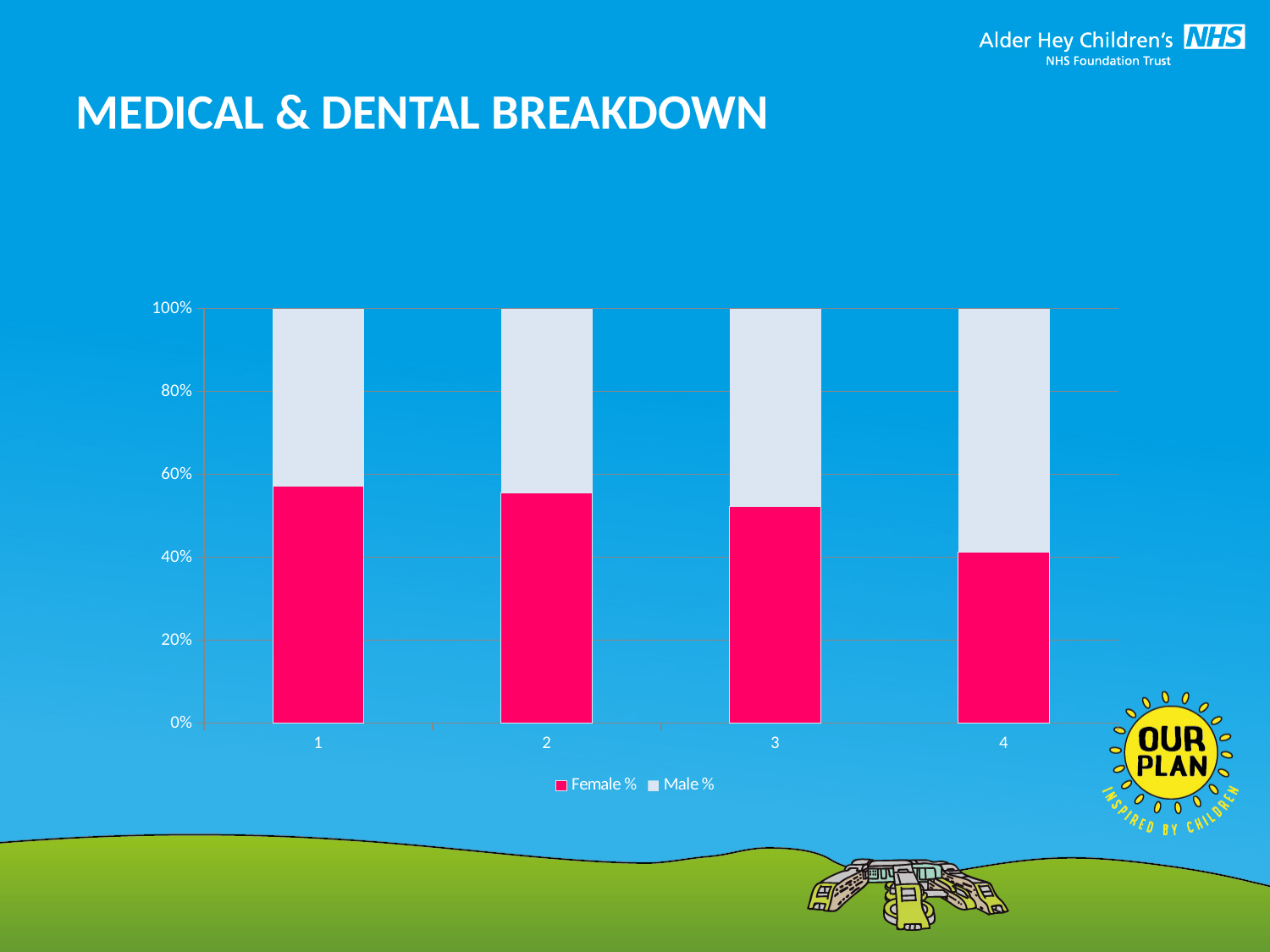
What is the title of the slide containing the chart? MEDICAL & DENTAL BREAKDOWN Which is larger, the Female % value for category 1 or for category 4? Category 1 How many categories are shown on the x axis? 4 Is the Female % value for category 1 greater or less than 40%? greater Is the Female % value for category 4 greater or less than 60%? less In category 4, which is larger, Female % or Male %? Male % How many series does the legend list? 2 Which category has the highest Male % value? 4 Which category has the lowest Female % value? 4 What kind of chart is shown on the slide? Stacked bar chart Does the Female % value rise or fall from category 1 to category 4? Fall Which series is shown in pink? Female %